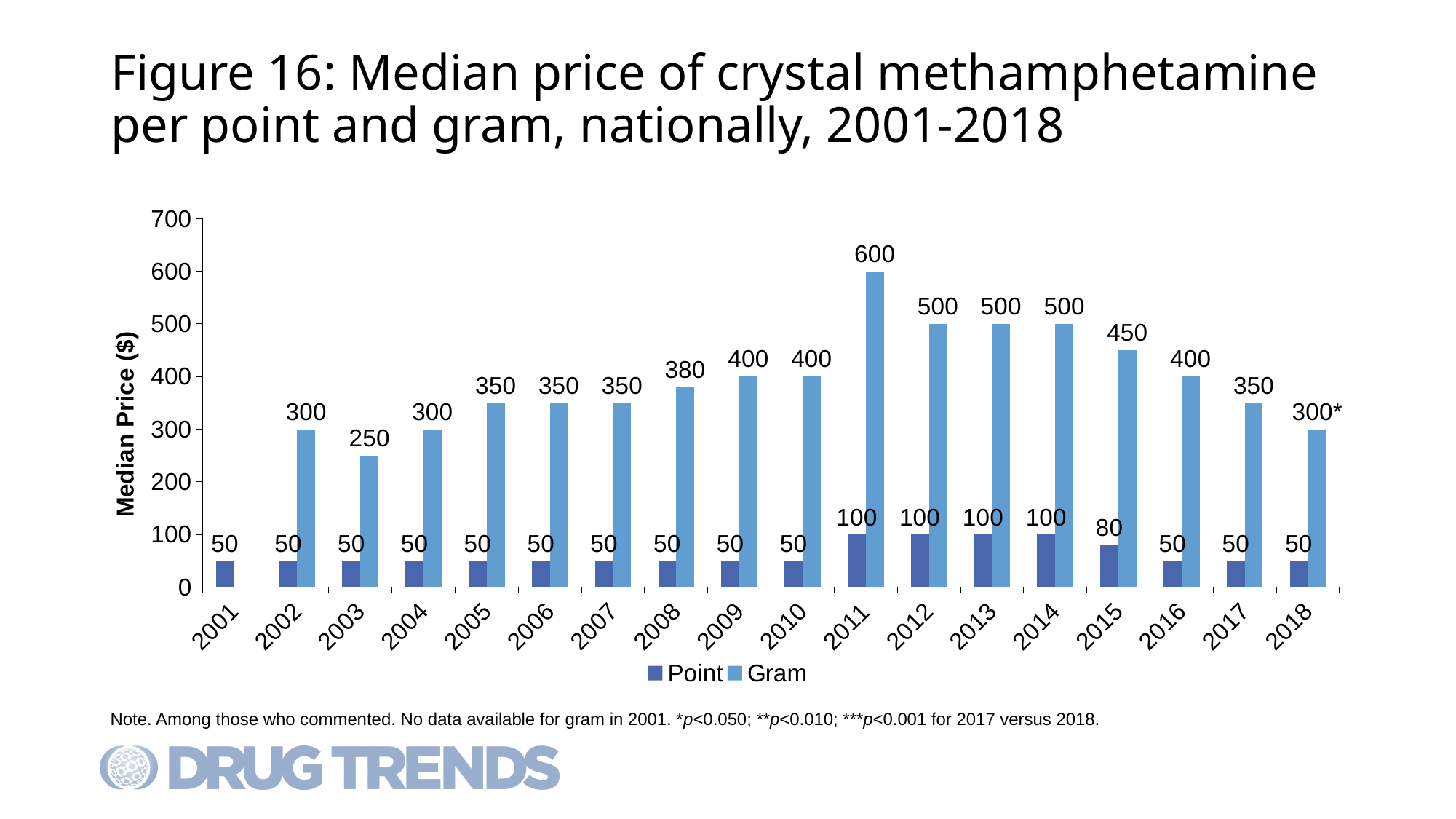
Which is larger, the median price per gram in 2008 or in 2017? 2008 What is the difference between the median price per gram in 2011 and in 2012? 100 What is the label of the y axis? Median Price ($) In which year is the median price per gram lowest? 2003 How many years are shown on the x axis? 18 Does the median price per gram rise or fall from 2014 to 2018? Fall What is the median price per gram in 2018? 300* What is the median price per point in 2015? 80 In which year is the median price per gram highest? 2011 How many series does the legend list? 2 What is the median price per gram in 2011? 600 What kind of chart is shown on the slide? Bar chart